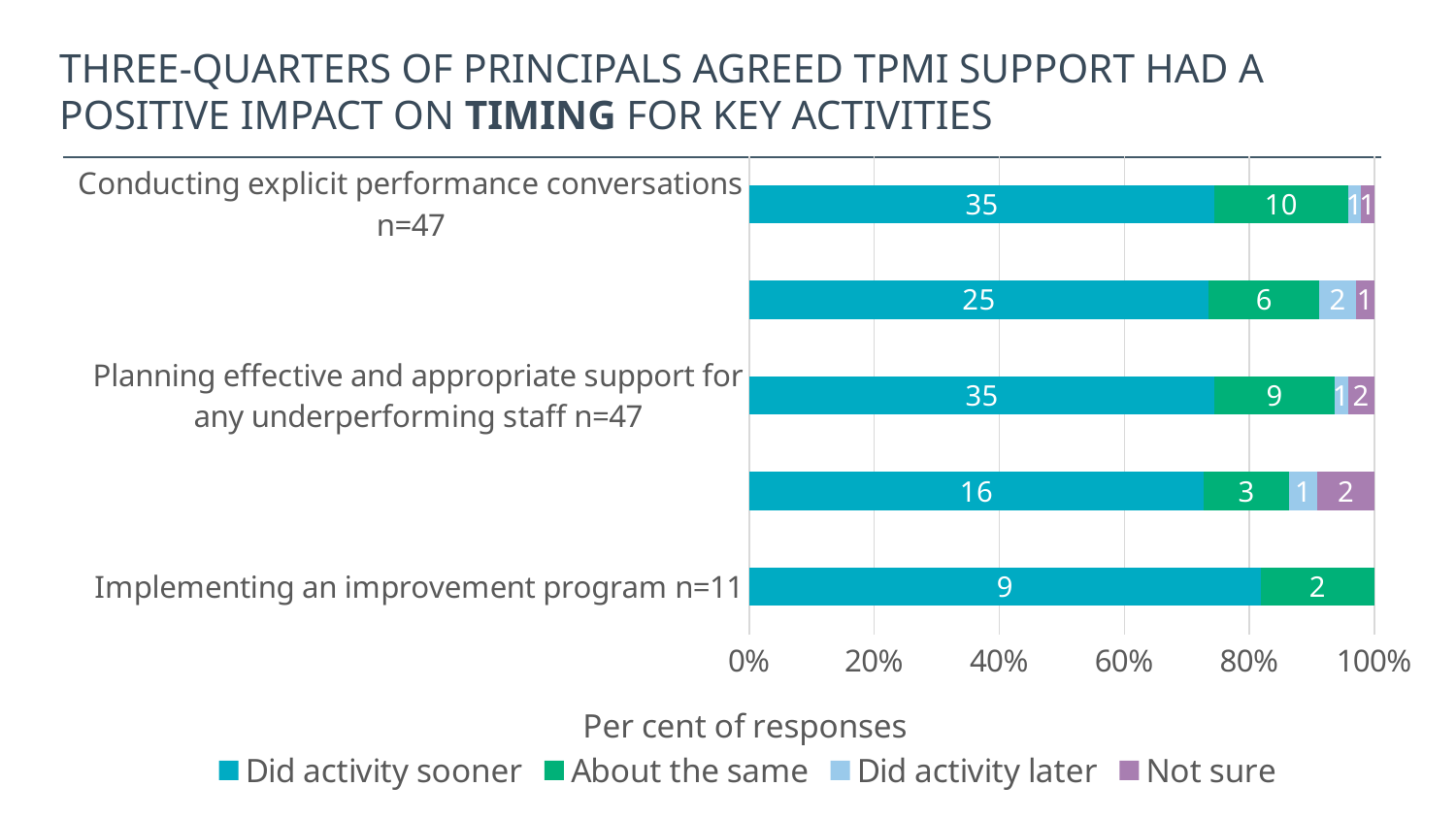
What is the 'Did activity sooner' value for 'Implementing an improvement program n=11'? 9 What is the total of all segments in the 'Conducting explicit performance conversations n=47' bar? 47 What is the title of the horizontal axis? Per cent of responses How many bars are plotted in the chart? 5 What is the 'About the same' value for 'Implementing an improvement program n=11'? 2 How many responses for 'Conducting explicit performance conversations n=47' were 'Did activity sooner'? 35 What kind of chart is shown on the slide? Stacked bar chart What is the 'About the same' value for 'Planning effective and appropriate support for any underperforming staff n=47'? 9 For 'Conducting explicit performance conversations n=47', what is the difference between the 'Did activity sooner' and 'About the same' values? 25 How many series does the legend list? 4 Which has the larger 'About the same' value: 'Conducting explicit performance conversations n=47' or 'Planning effective and appropriate support for any underperforming staff n=47'? Conducting explicit performance conversations n=47 What is the 'Not sure' value for 'Planning effective and appropriate support for any underperforming staff n=47'? 2